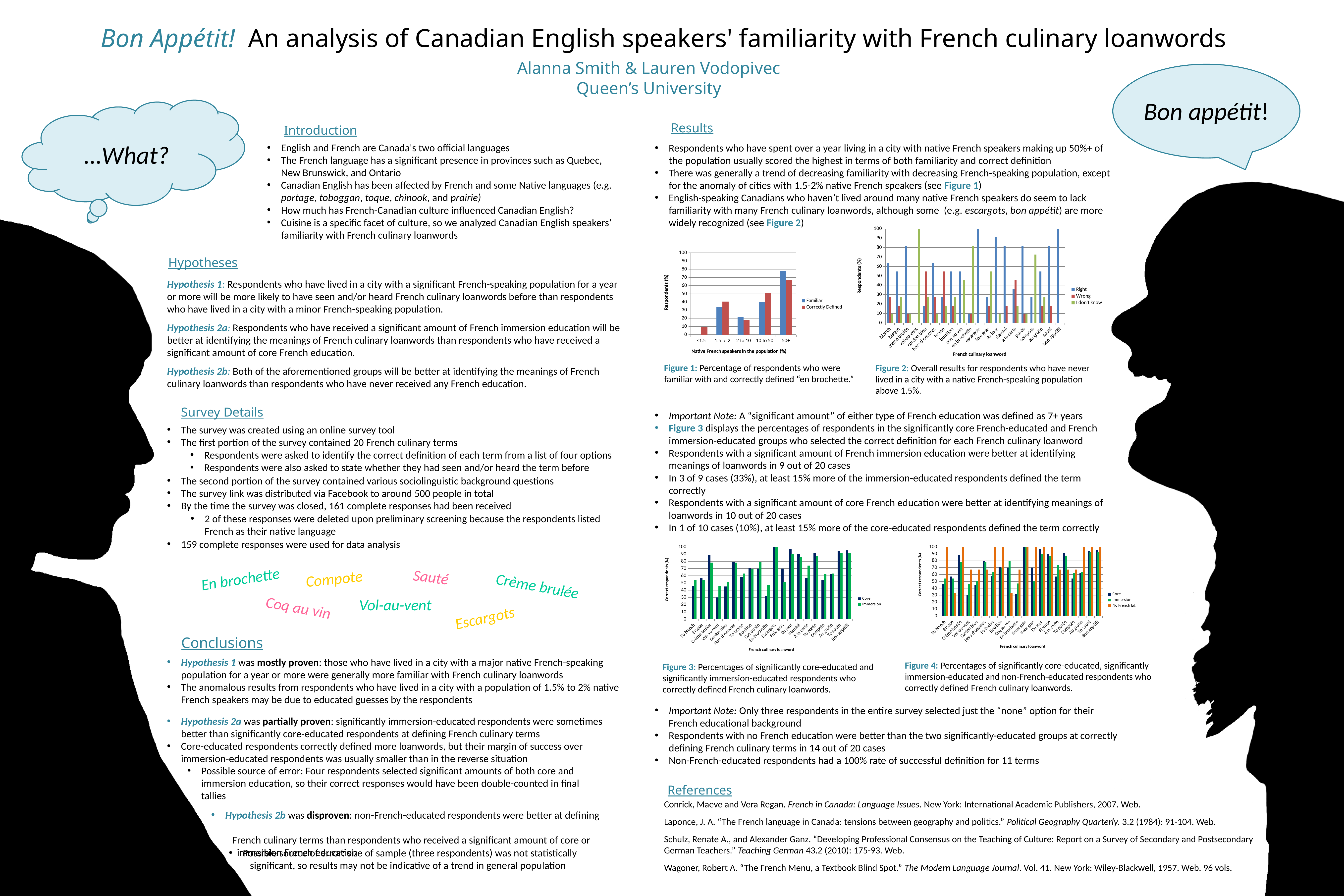
What kind of chart is Figure 1? bar chart What is the x-axis title of Figure 1? Native French speakers in the population (%) In Figure 4, how many series does the legend list? 3 In Figure 1, for the 1.5 to 2 category, which is larger: Familiar or Correctly Defined? Correctly Defined In Figure 1, is the Familiar value for 50+ greater or less than 70? greater In Figure 1, how many series does the legend list? 2 In Figure 1, is the Correctly Defined value for <1.5 greater or less than 20? less In Figure 1, which population category has the highest Familiar value? 50+ In Figure 2, how many series does the legend list? 3 In Figure 1, how many population categories are shown on the x axis? 5 In Figure 1, which has the larger Familiar value: 10 to 50 or 50+? 50+ What are the legend entries in Figure 2? Right, Wrong, I don't know